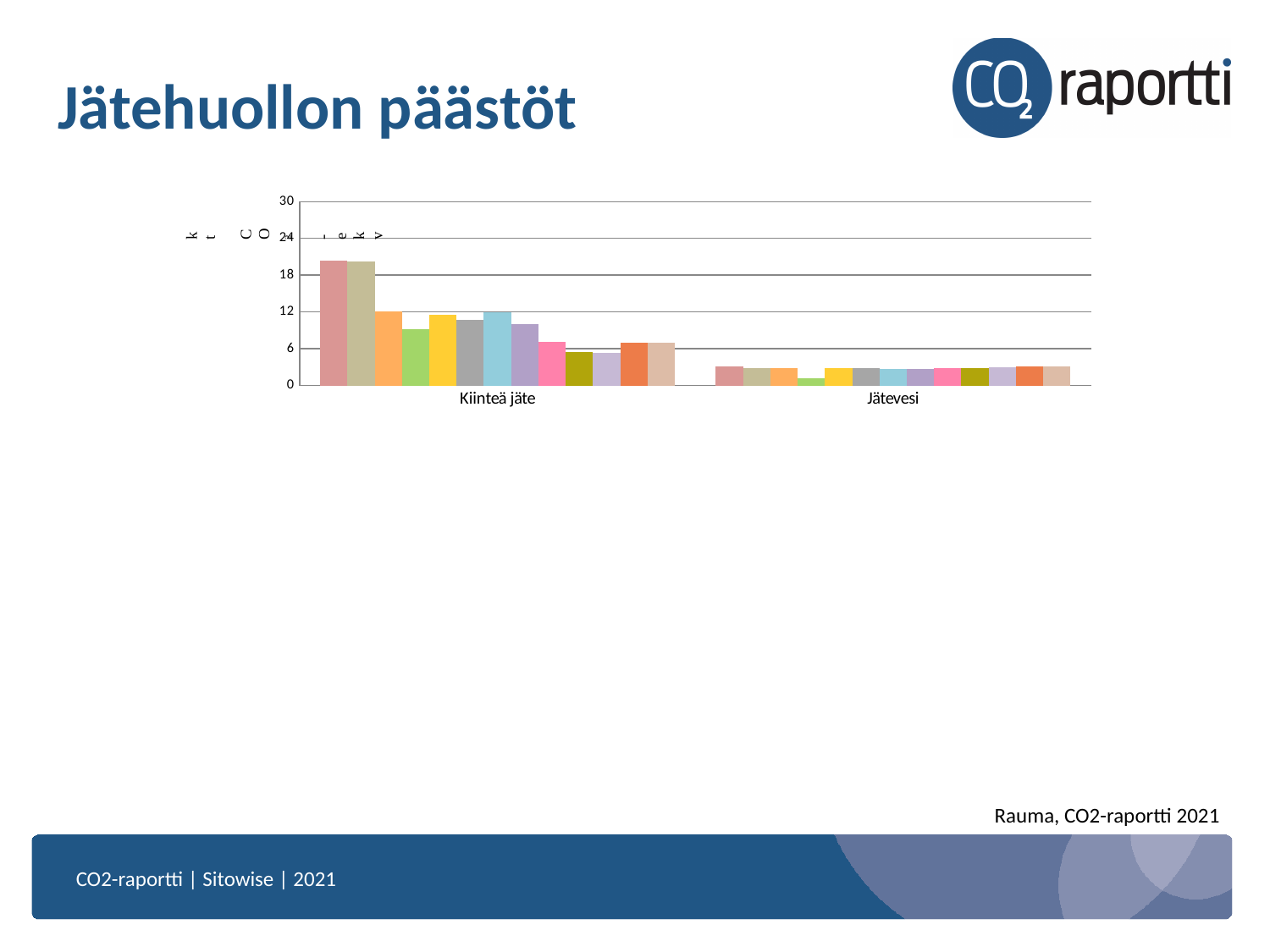
Is the value of the last (rightmost) bar in the Kiinteä jäte group greater or less than 12? less Is the value of the first (leftmost) bar in the Kiinteä jäte group greater or less than 24? less Which category has the higher values overall, Kiinteä jäte or Jätevesi? Kiinteä jäte How many categories are shown on the x axis of the chart? 2 What are the two categories on the x axis of the chart? Kiinteä jäte and Jätevesi What is the highest value shown on the y axis of the chart? 30 What kind of chart is shown on the slide? bar chart Do the bars in the Kiinteä jäte group generally rise or fall from left to right? fall Is the value of the green bar in the Jätevesi group greater or less than 6? less What is the title of the slide containing the chart? Jätehuollon päästöt